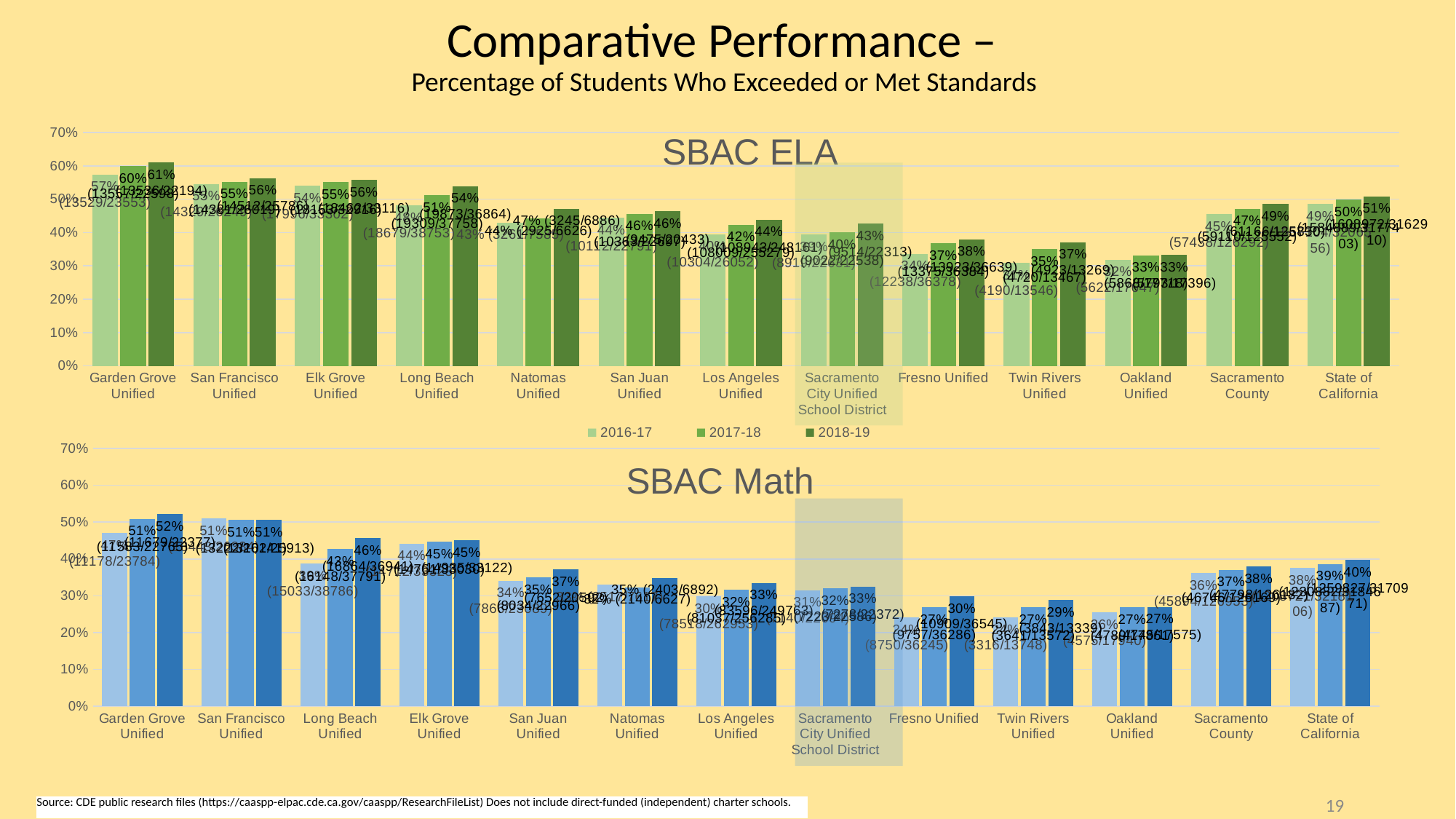
In the SBAC ELA chart, do the values for Fresno Unified rise or fall from 2016-17 to 2018-19? rise In the SBAC ELA chart, what is the 2018-19 value for Garden Grove Unified? 61% In the SBAC ELA chart, which district or region has the lowest 2018-19 value? Oakland Unified How many series does the legend list for the SBAC ELA chart? 3 What kind of chart is the SBAC ELA chart at the top of the slide? bar chart In the SBAC Math chart, what is the difference between the 2018-19 values for Garden Grove Unified (52%) and Oakland Unified (27%)? 25 percentage points In the SBAC Math chart, what is the 2018-19 value for State of California? 40% In the SBAC Math chart, is the 2018-19 value for Twin Rivers Unified greater or less than 30%? less How many districts or regions are shown along the x axis of the SBAC Math chart? 13 In the SBAC ELA chart, which is larger: the 2018-19 value for Sacramento County or the 2018-19 value for Fresno Unified? Sacramento County In the SBAC Math chart, what is the 2018-19 value for Sacramento City Unified School District? 33% In the SBAC ELA chart, which district or region has the highest 2018-19 value? Garden Grove Unified